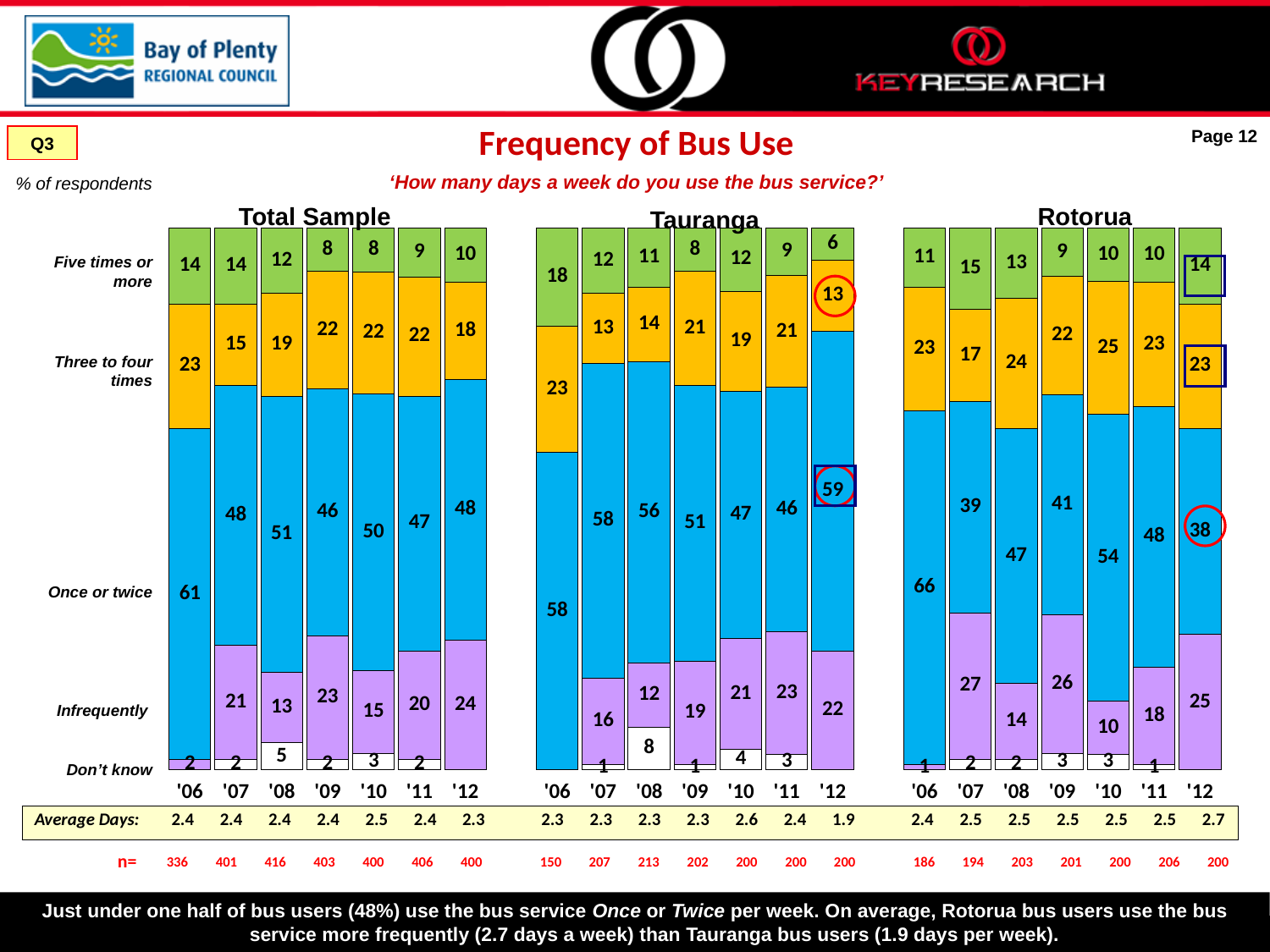
In the Total Sample chart, what percentage of respondents used the bus 'Once or twice' a week in '06? 61 In the Tauranga chart, what is the total of the '12 bar (6 + 13 + 59 + 22)? 100 In the Tauranga chart, what is the 'Once or twice' value for '12? 59 In the Rotorua chart, what is the 'Infrequently' value for '07? 27 What type of chart is used for the Rotorua data? Stacked bar chart How many years are shown on the x axis of the Tauranga chart? 7 In the Tauranga chart, which year has the lowest 'Five times or more' value? '12 In the Rotorua chart, is the 'Once or twice' value larger in '10 or in '12? '10 In the Rotorua chart, which year has the highest 'Once or twice' value? '06 In the Total Sample chart, what is the difference between the 'Infrequently' values for '12 and '08? 11 What is the Average Days value shown for Rotorua in '12? 2.7 How many response categories are stacked in each bar of the Total Sample chart? 5